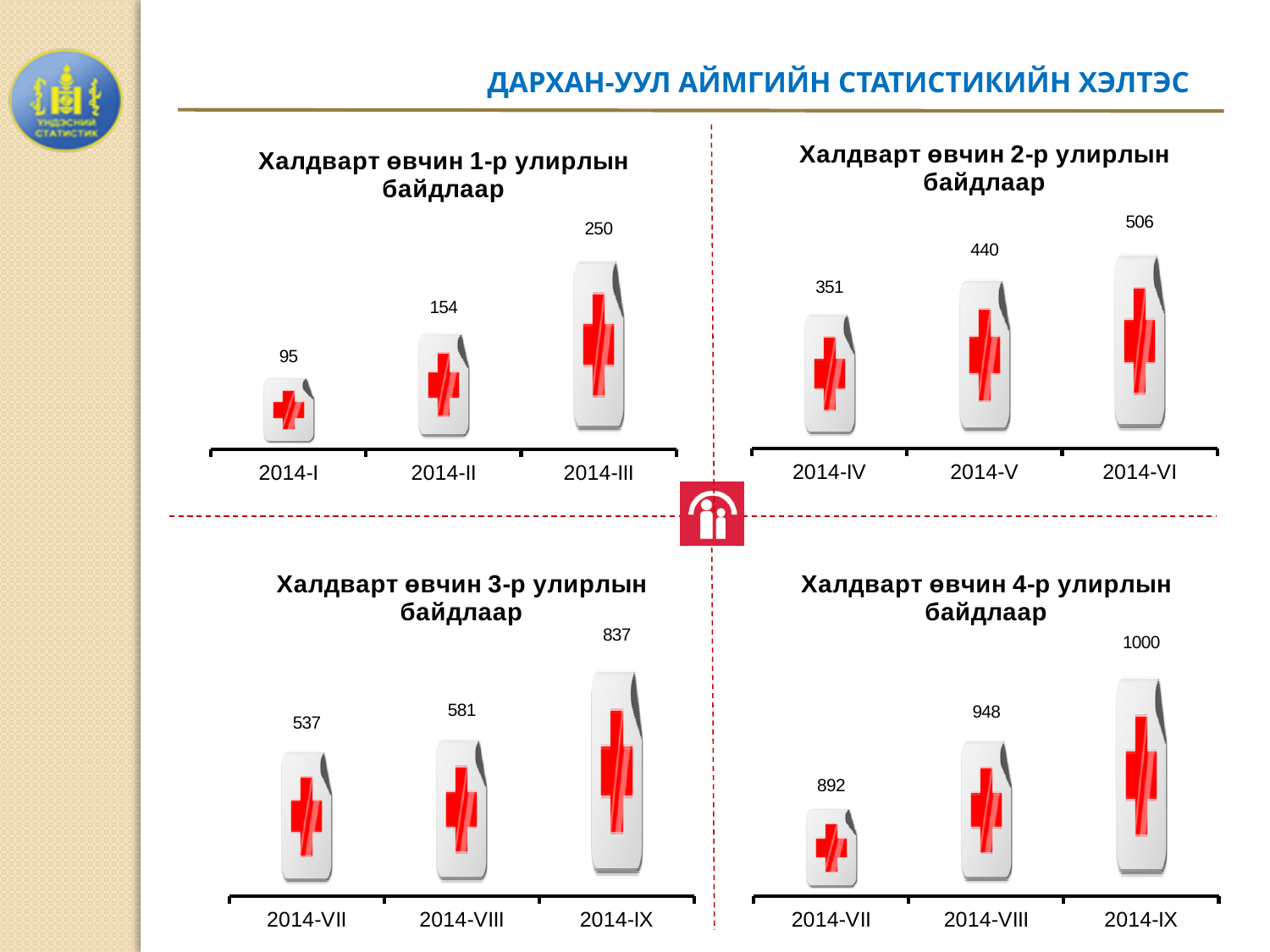
What kind of chart is the top-left chart (Халдварт өвчин 1-р улирлын байдлаар)? bar chart In the bottom-right chart (Халдварт өвчин 4-р улирлын байдлаар), what is the difference between the values for 2014-IX and 2014-VIII? 52 In the top-left chart (Халдварт өвчин 1-р улирлын байдлаар), what is the value for 2014-II? 154 In the top-left chart (Халдварт өвчин 1-р улирлын байдлаар), what is the difference between the values for 2014-III and 2014-I? 155 In the top-left chart (Халдварт өвчин 1-р улирлын байдлаар), which category has the lowest value? 2014-I In the top-right chart (Халдварт өвчин 2-р улирлын байдлаар), which category has the highest value? 2014-VI In the bottom-left chart (Халдварт өвчин 3-р улирлын байдлаар), what is the value for 2014-IX? 837 In the bottom-right chart (Халдварт өвчин 4-р улирлын байдлаар), what is the value for 2014-VII? 892 How many categories are shown in the bottom-right chart (Халдварт өвчин 4-р улирлын байдлаар)? 3 In the top-right chart (Халдварт өвчин 2-р улирлын байдлаар), what is the value for 2014-V? 440 In the top-right chart (Халдварт өвчин 2-р улирлын байдлаар), do the values rise or fall from 2014-IV to 2014-VI? rise In the bottom-left chart (Халдварт өвчин 3-р улирлын байдлаар), which is larger, the value for 2014-VII or 2014-VIII? 2014-VIII